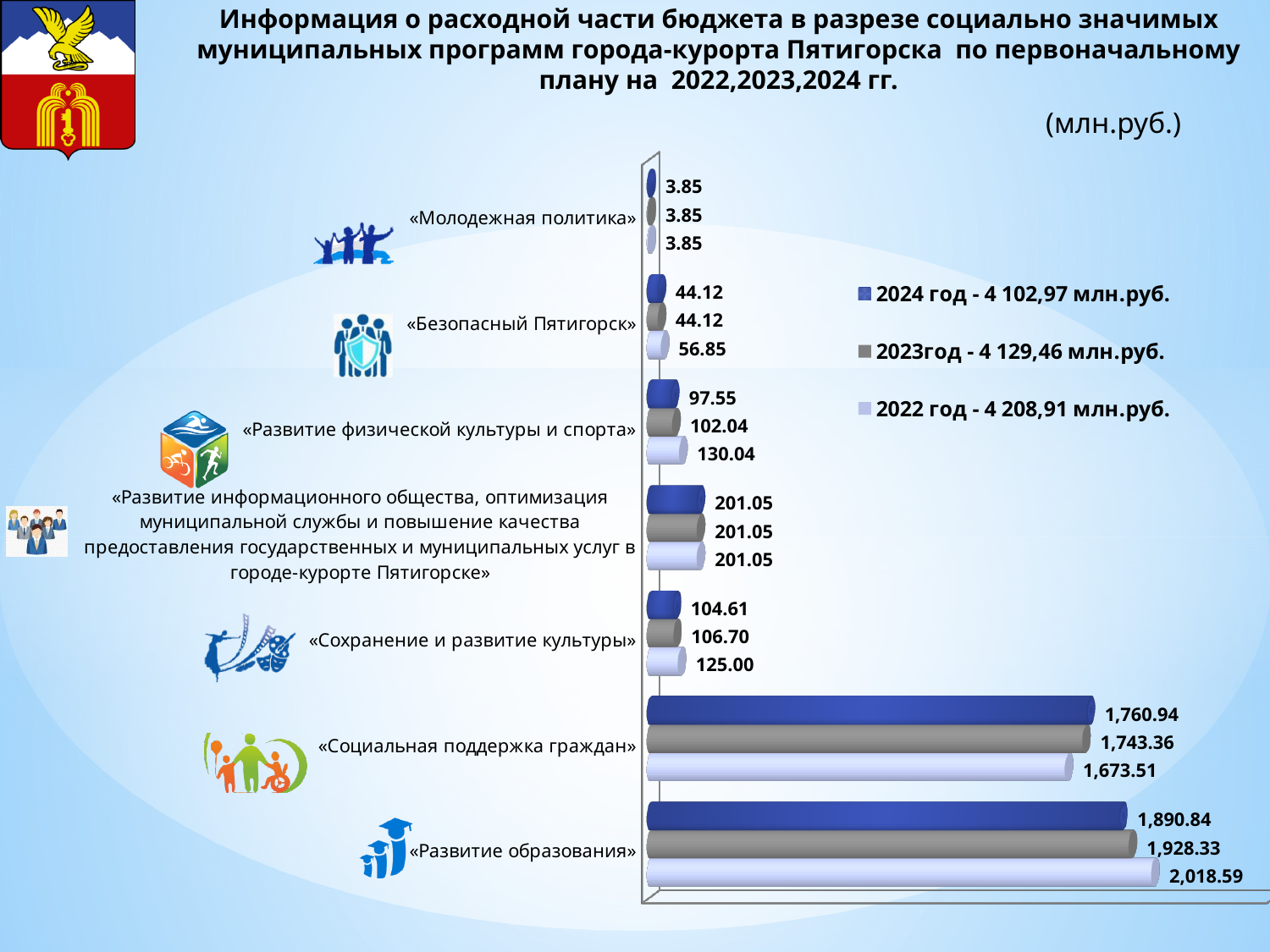
According to the legend, what is the total for 2023? 4 129,46 млн.руб. What is the value for «Сохранение и развитие культуры» in the 2023 series? 106.70 What is the difference between the 2022 and 2024 values for «Развитие физической культуры и спорта»? 32.49 What is the value for «Социальная поддержка граждан» in the 2024 series? 1,760.94 How many series does the legend list? 3 What kind of chart is shown on the slide? bar chart How many programme categories are plotted in the chart? 7 What is the value for «Безопасный Пятигорск» in the 2022 series? 56.85 Which category has the lowest value in the 2023 series? «Молодежная политика» For «Социальная поддержка граждан», which is larger: the 2024 value or the 2022 value? 2024 What is the value for «Развитие образования» in the 2022 series? 2,018.59 Which category has the highest value in the 2024 series? «Развитие образования»